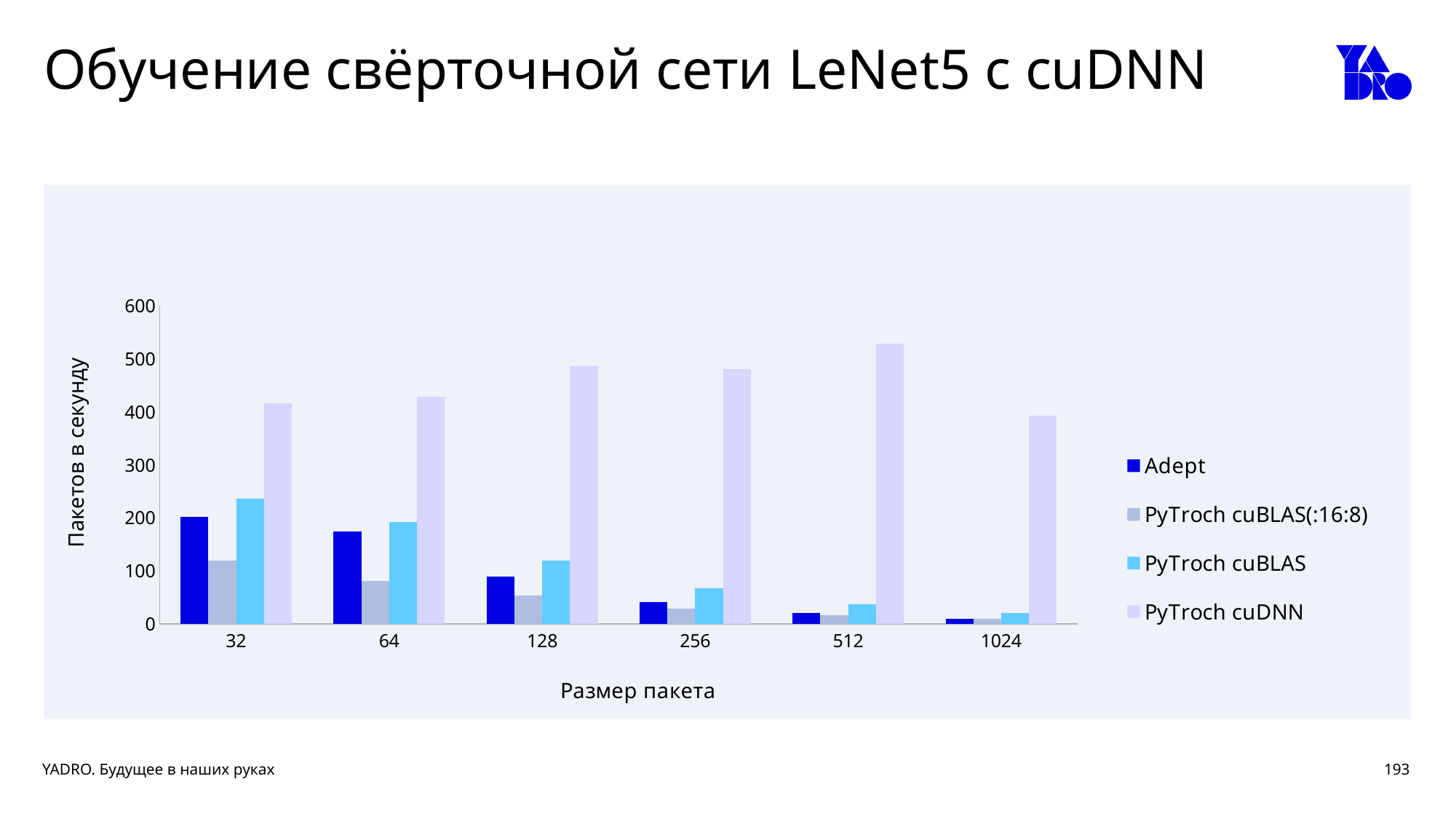
What kind of chart is shown on the slide? bar chart Is the PyTroch cuDNN value for batch size 1024 greater or less than 300? greater Is the PyTroch cuDNN value for batch size 512 greater or less than 500? greater For batch size 32, which is larger: the Adept value or the PyTroch cuBLAS value? PyTroch cuBLAS How many batch sizes (categories) are shown on the x axis? 6 Is the Adept value for batch size 32 greater or less than 300? less For which batch size is the PyTroch cuDNN value highest? 512 How many series does the legend list? 4 What is the title of the y axis? Пакетов в секунду For which batch size is the Adept value lowest? 1024 Do the Adept values rise or fall as the batch size increases along the x axis? fall Which series has the highest value for batch size 256? PyTroch cuDNN